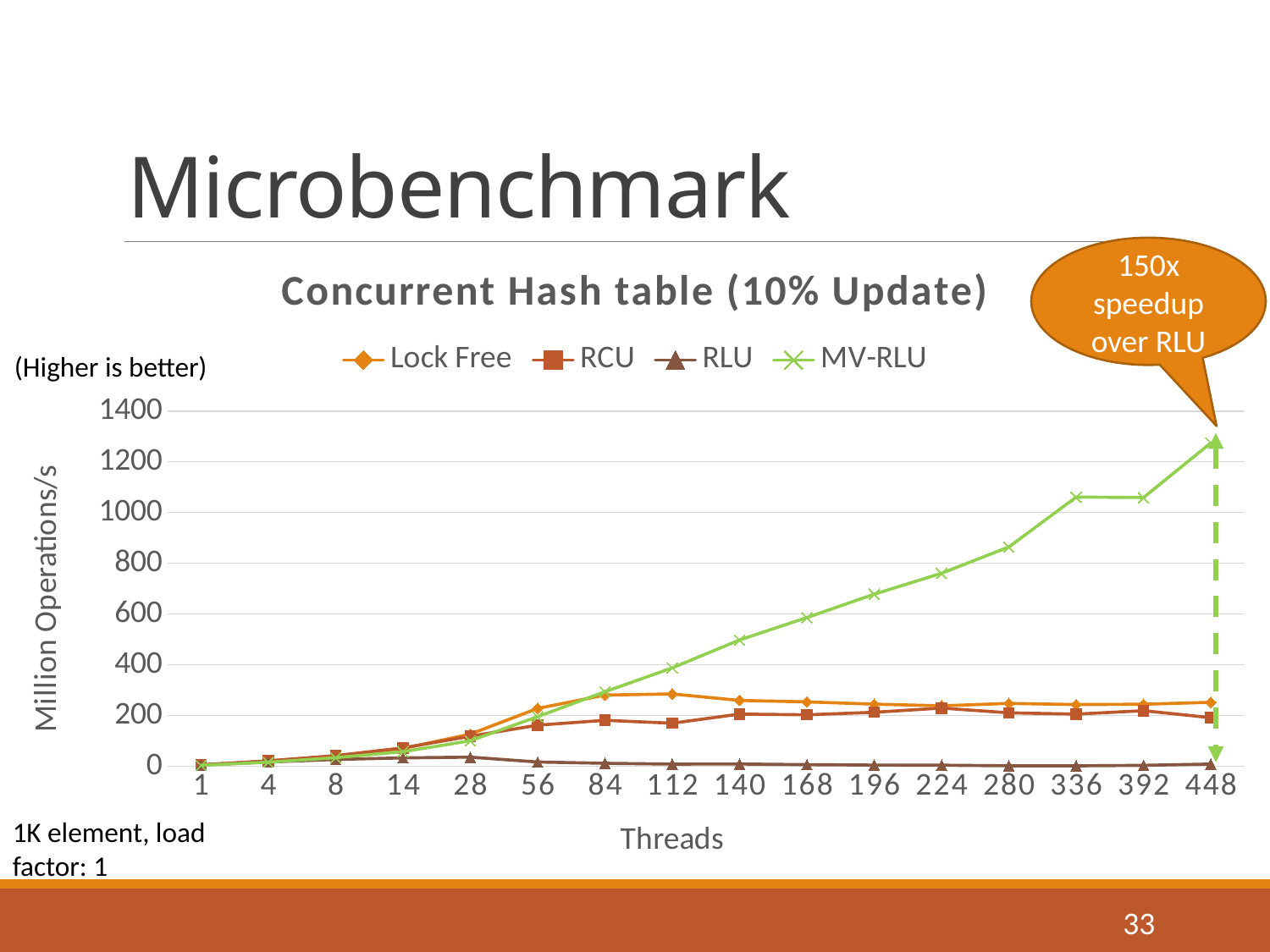
How many series does the legend list? 4 Does the MV-RLU series generally rise or fall as the number of threads increases? rise What is the label of the y axis? Million Operations/s At 448 threads, which is larger: Lock Free or RCU? Lock Free Is the value for RLU at 448 threads greater or less than 200? less Is the value for MV-RLU at 224 threads greater or less than 600? greater What is the title of the chart? Concurrent Hash table (10% Update) What kind of chart is shown on the slide? line chart How many thread counts are plotted along the x axis? 16 Is the value for MV-RLU at 448 threads greater or less than 1200? greater Which series has the highest value at 448 threads? MV-RLU Which series has the lowest value at 448 threads? RLU